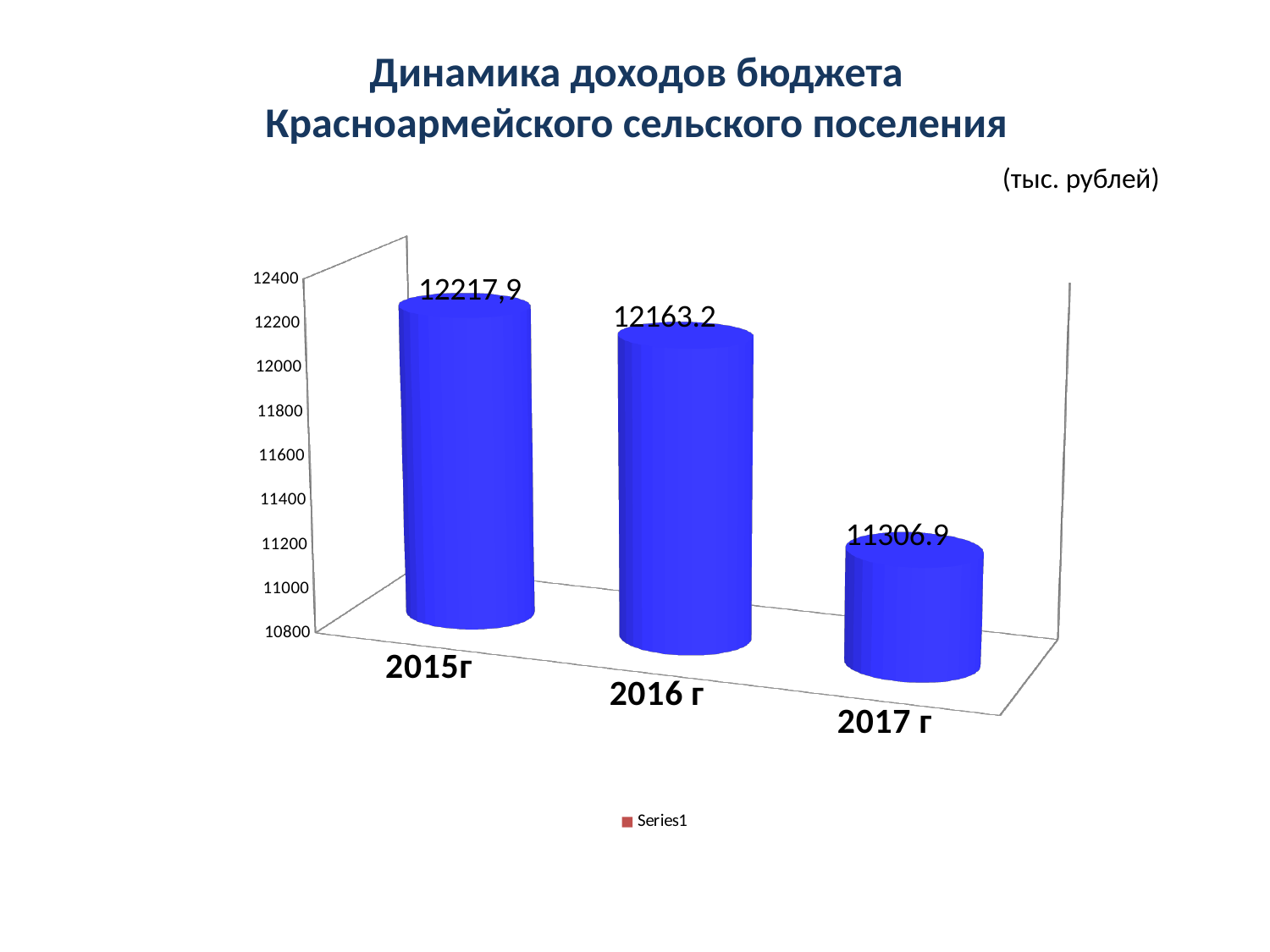
What is the difference between the values for 2016 г and 2017 г? 856.3 Is the value for 2017 г greater or less than 11400? less Which year has the lowest value? 2017 г Which is larger, the value for 2016 г or the value for 2017 г? 2016 г What is the difference between the values for 2015г and 2017 г? 911.0 Which year has the highest value? 2015г What is the value shown for 2016 г? 12163.2 What kind of chart is shown on the slide? bar chart Do the values rise or fall from 2015г to 2017 г? fall What is the value shown for 2015г? 12217,9 How many years are shown on the chart? 3 What is the value shown for 2017 г? 11306.9